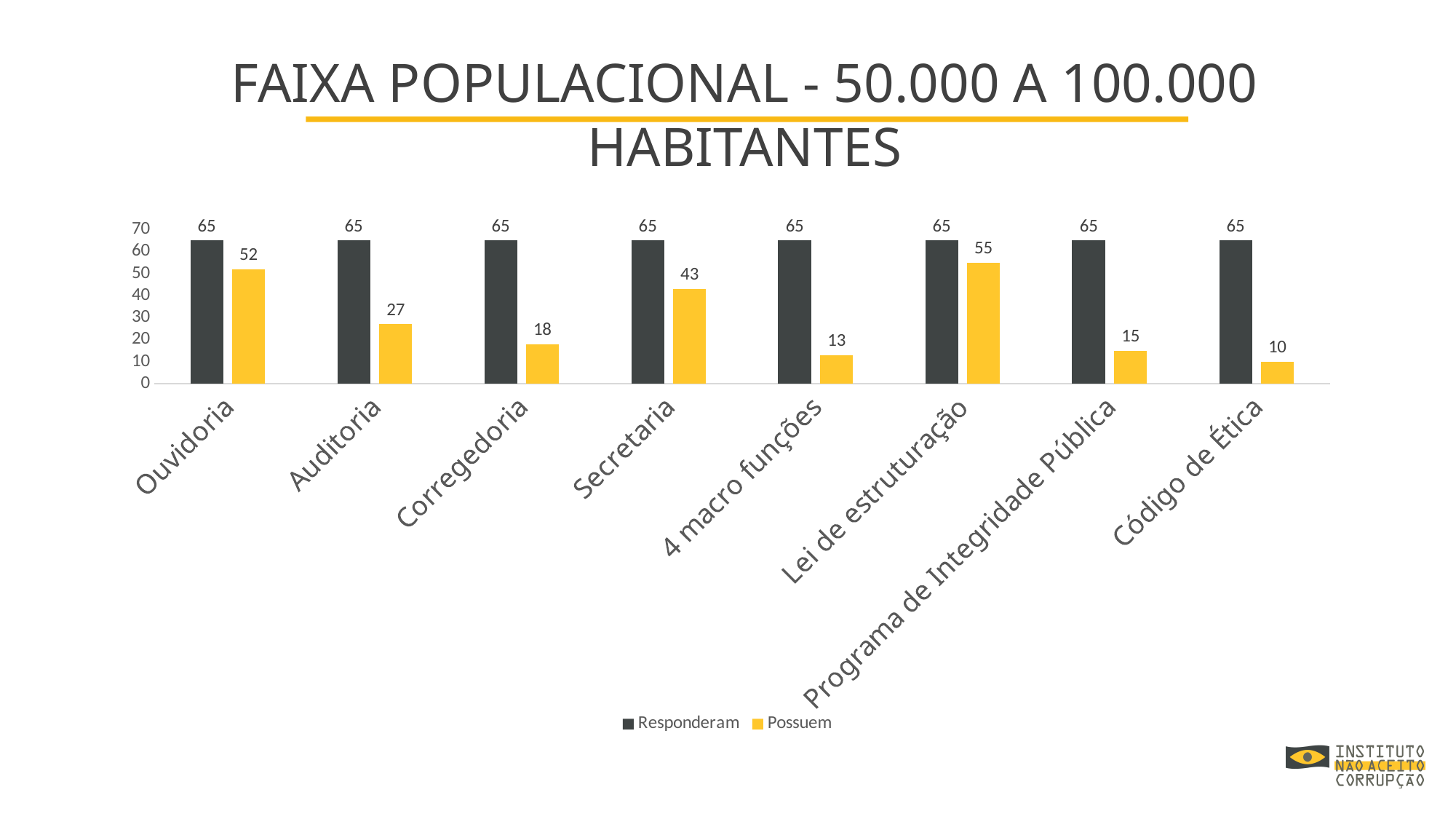
What colour are the Possuem bars? yellow Is the Possuem value for 4 macro funções greater or less than 20? less What is the Responderam value for Secretaria? 65 What kind of chart is shown on the slide? bar chart How many series does the legend list? 2 Which category has the lowest Possuem value? Código de Ética What is the difference between the Responderam and Possuem values for Auditoria? 38 Which has a larger Possuem value, Secretaria or Corregedoria? Secretaria What is the Possuem value for Ouvidoria? 52 What is the Possuem value for Lei de estruturação? 55 How many categories are shown on the x axis? 8 Which category has the highest Possuem value? Lei de estruturação